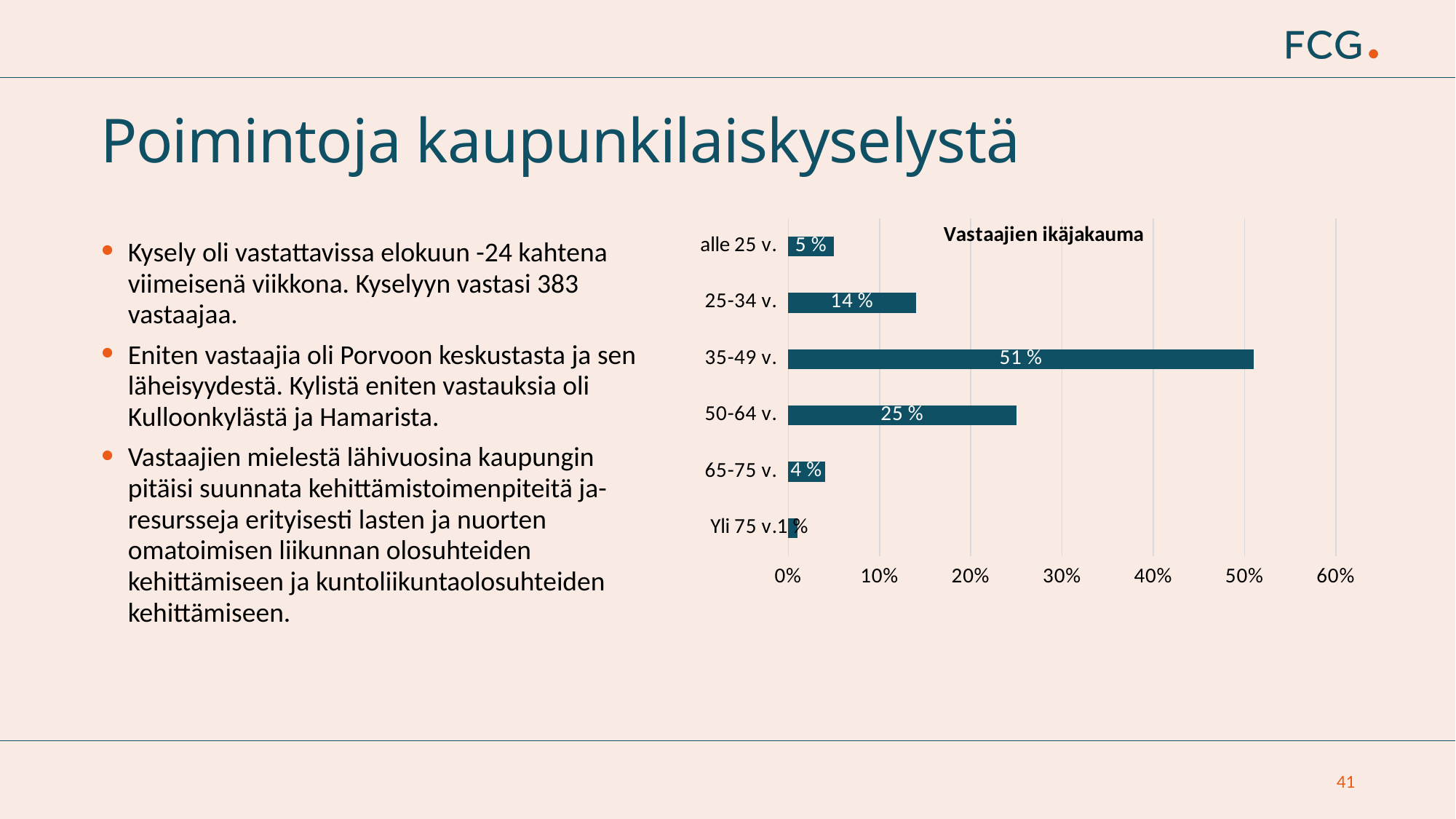
How many age categories are shown in the chart? 6 What share of respondents are in the 25-34 v. age group? 14 % What is the value for the alle 25 v. category? 5 % Which age group has the lowest share of respondents? Yli 75 v. Which age group has the highest share of respondents? 35-49 v. Which is larger, the value for 25-34 v. or the value for 65-75 v.? 25-34 v. What kind of chart is shown on the slide? Bar chart What is the difference between the 35-49 v. and 50-64 v. values? 26 % What is the value for the 35-49 v. age group in the Vastaajien ikäjakauma chart? 51 % What is the title of the chart? Vastaajien ikäjakauma What is the value shown for the 50-64 v. category? 25 % Is the value for 35-49 v. greater or less than 50%? greater